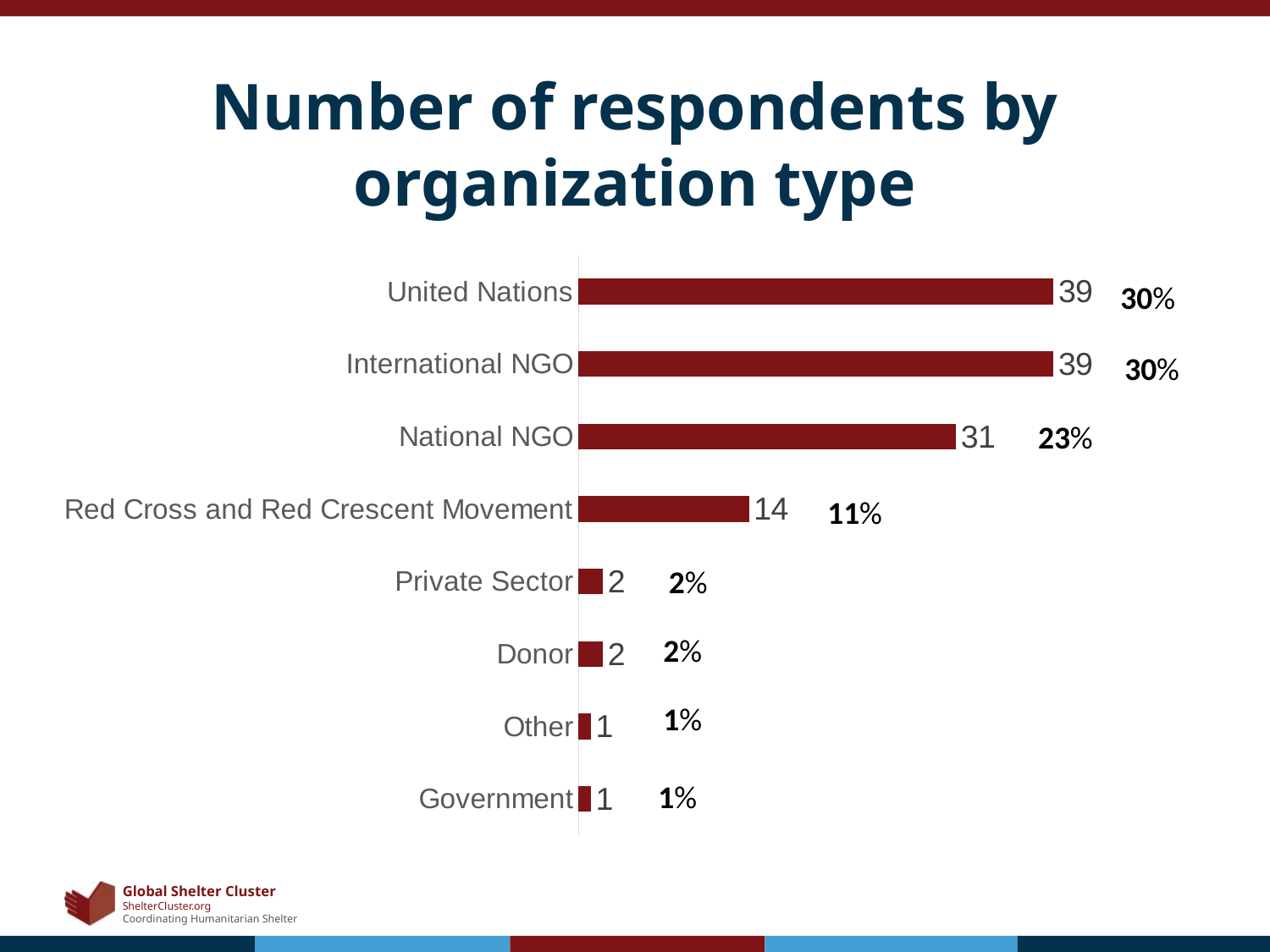
How many respondents are from the United Nations? 39 Which organization type has the fewest respondents, Government or Donor? Government What percentage of respondents are from the Red Cross and Red Crescent Movement? 11% How many organization types are shown in the chart? 8 What is the difference in the number of respondents between International NGO and National NGO? 8 What is the difference in the number of respondents between National NGO and Red Cross and Red Crescent Movement? 17 What is the title of the chart on the slide? Number of respondents by organization type How many respondents are from National NGOs? 31 What kind of chart is shown on the slide? Bar chart Which has more respondents, National NGO or Red Cross and Red Crescent Movement? National NGO What percentage of respondents are from Donor organizations? 2% How many respondents are from the Private Sector? 2